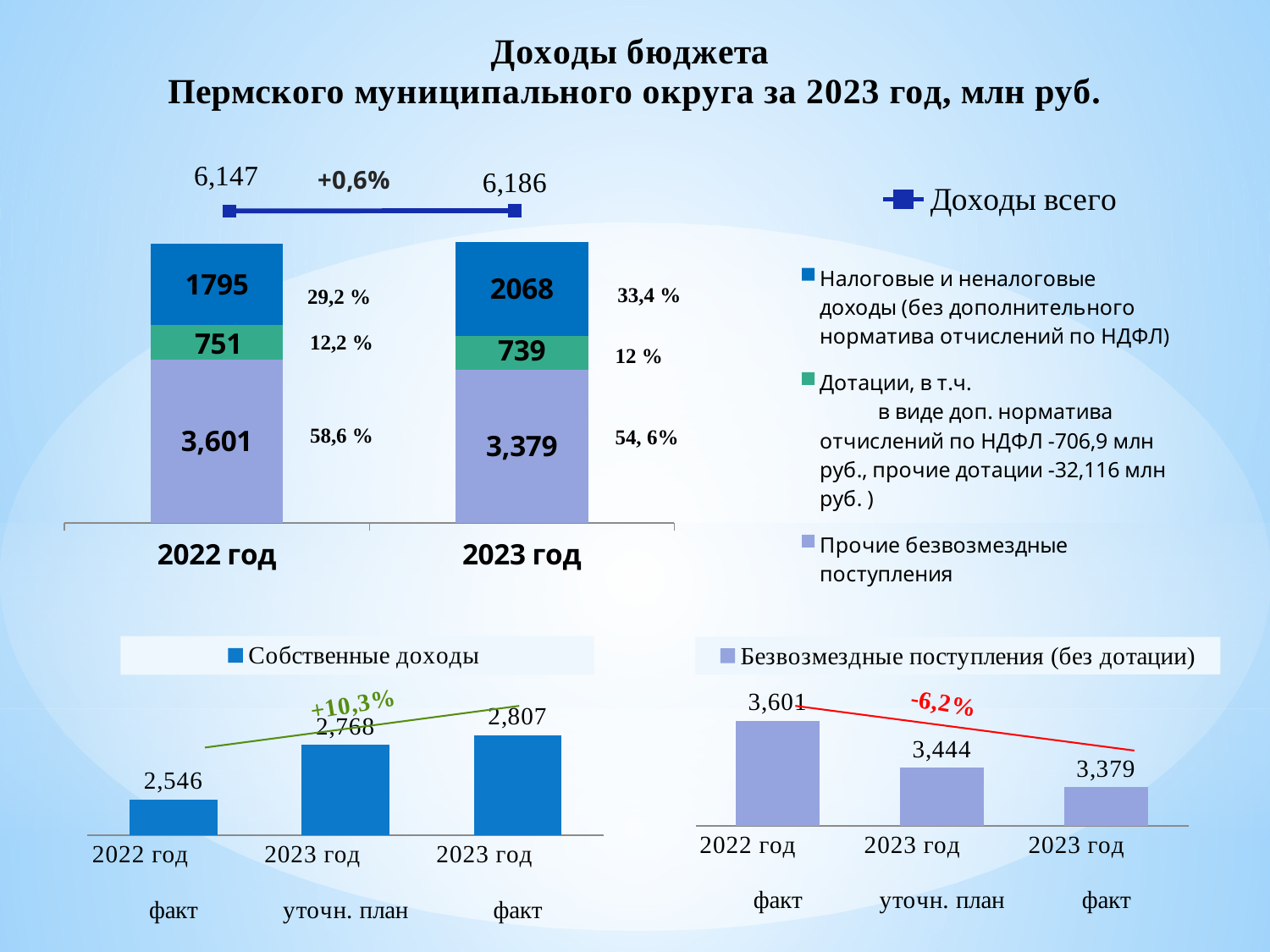
In the bottom-right chart 'Безвозмездные поступления (без дотации)', which category has the highest value? 2022 год факт In the bottom-left chart 'Собственные доходы', what is the difference between the 2023 год факт value and the 2022 год факт value? 261 In the bottom-left chart 'Собственные доходы', which category has the lowest value? 2022 год факт What kind of chart is the bottom-left chart 'Собственные доходы'? bar chart In the top stacked bar chart, what percentage is shown next to the light purple segment for 2022 год? 58,6 % In the top stacked bar chart, what is the total shown above the 2022 год bar? 6,147 In the top stacked bar chart, which year has the larger green segment, 2022 год or 2023 год? 2022 год In the bottom-left chart 'Собственные доходы', what is the value for 2023 год факт? 2,807 In the bottom-right chart 'Безвозмездные поступления (без дотации)', how many bars are plotted? 3 In the bottom-right chart 'Безвозмездные поступления (без дотации)', what is the difference between the 2022 год факт value and the 2023 год факт value? 222 In the bottom-right chart 'Безвозмездные поступления (без дотации)', do the values rise or fall from left to right? fall In the top stacked bar chart, what is the value of the top dark blue segment for 2023 год? 2068